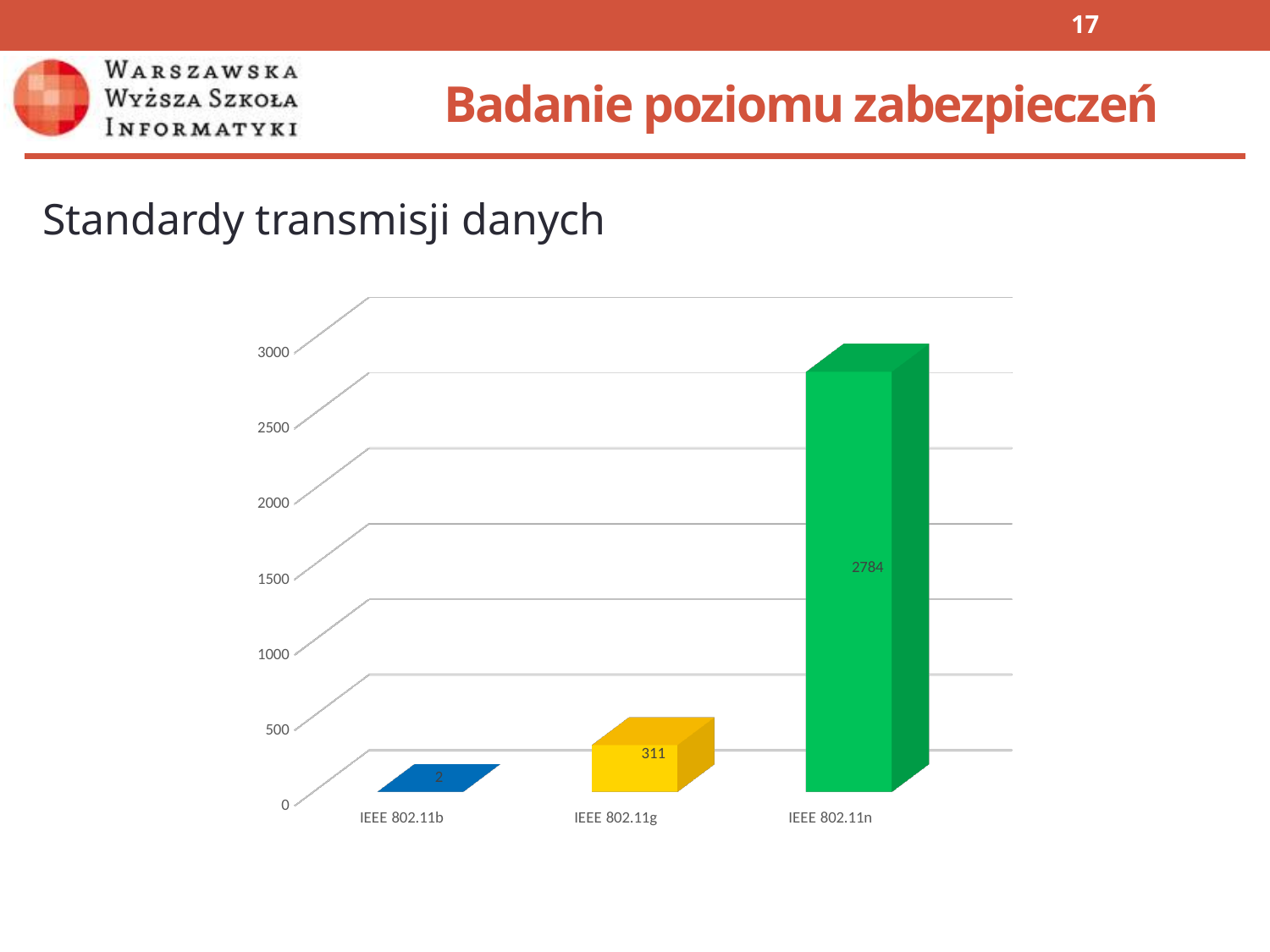
What is the value for IEEE 802.11b? 2 What is the value for IEEE 802.11n? 2784 Which standard has the lowest value? IEEE 802.11b Which standard has the highest value? IEEE 802.11n How many standards are shown on the chart? 3 Which is larger, the value for IEEE 802.11g or IEEE 802.11b? IEEE 802.11g Is the value for IEEE 802.11n greater or less than 2500? greater What colour is the bar for IEEE 802.11n? green What is the difference between the values for IEEE 802.11n and IEEE 802.11g? 2473 What is the value for IEEE 802.11g? 311 What kind of chart is shown on the slide? bar chart What is the difference between the values for IEEE 802.11g and IEEE 802.11b? 309